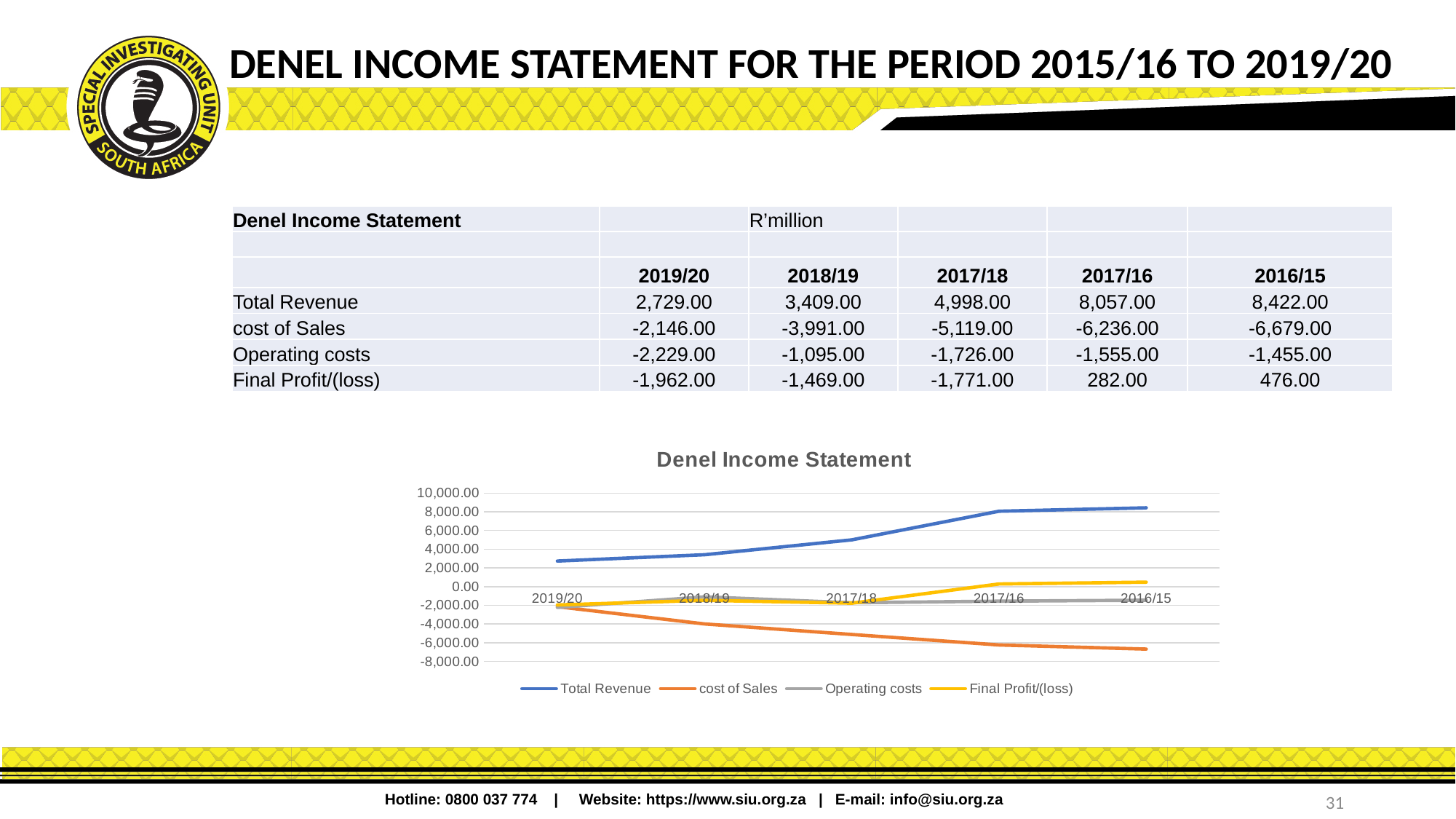
How many series does the chart legend list? 4 What kind of chart is shown on the slide? line chart What is the Total Revenue value for 2019/20? 2,729.00 Which is larger, Total Revenue in 2017/16 or in 2017/18? 2017/16 What is the Final Profit/(loss) value for 2017/18? -1,771.00 Is the Total Revenue value for 2017/16 greater or less than 6,000.00? greater What is the title of the chart? Denel Income Statement How many periods are plotted along the x axis of the chart? 5 In which period is Total Revenue highest? 2016/15 In which period is Final Profit/(loss) lowest? 2019/20 Does the Total Revenue line rise or fall moving from 2019/20 to 2016/15 along the x axis? rise What is the difference between Total Revenue in 2016/15 and in 2019/20? 5,693.00